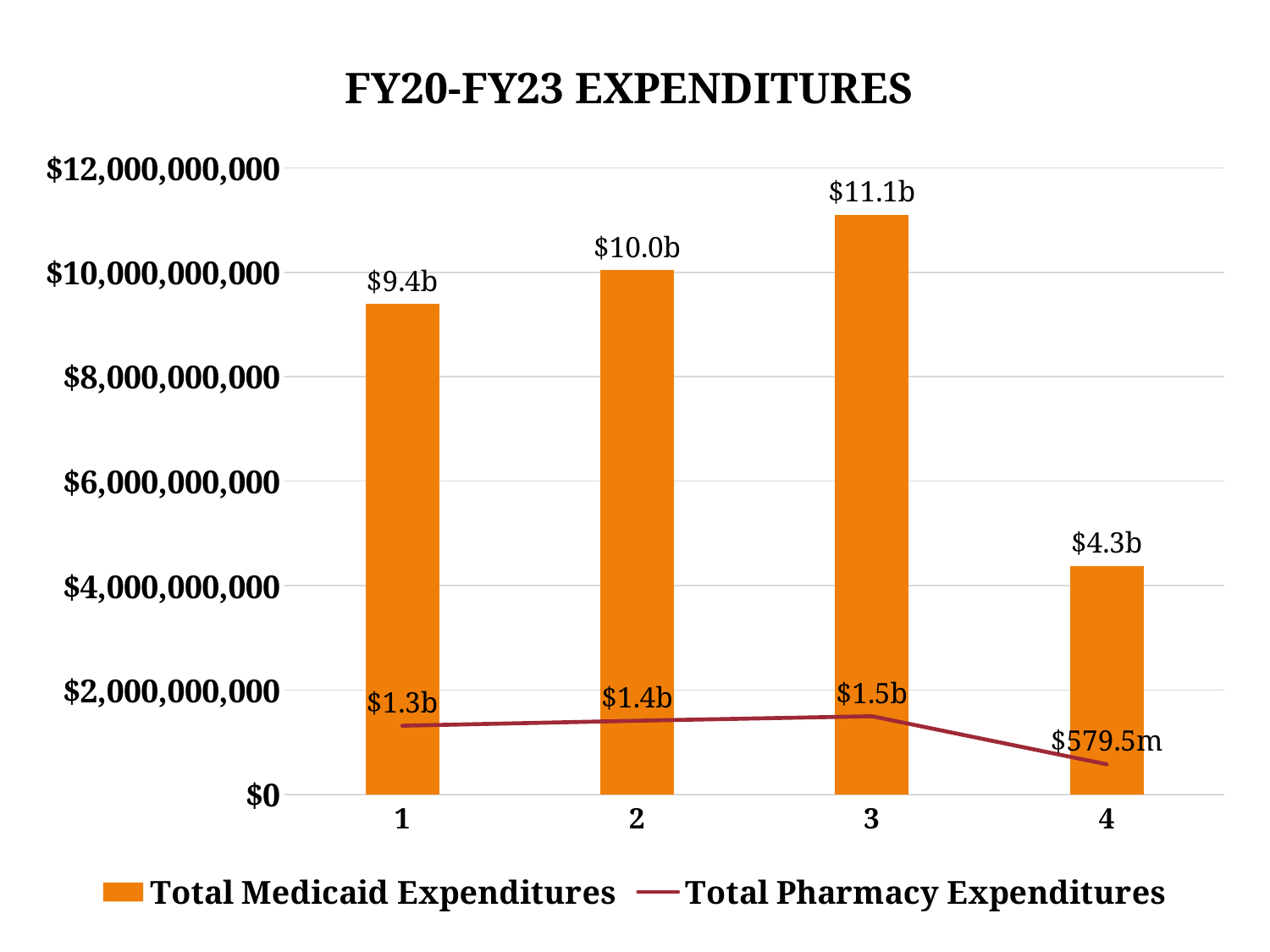
Which category has the highest Total Medicaid Expenditures? 3 Which is larger, Total Medicaid Expenditures for category 2 or for category 4? category 2 How many series does the legend list? 2 What is the Total Medicaid Expenditures value for category 3? $11.1b How many categories are shown on the x axis? 4 What is the Total Medicaid Expenditures value for category 1? $9.4b What is the title of the chart? FY20-FY23 EXPENDITURES Which category has the lowest Total Pharmacy Expenditures? 4 Is the Total Medicaid Expenditures value for category 2 greater or less than $8,000,000,000? greater Is the Total Medicaid Expenditures value for category 4 greater or less than $6,000,000,000? less What is the Total Pharmacy Expenditures value for category 4? $579.5m Which series is drawn as a line rather than bars? Total Pharmacy Expenditures